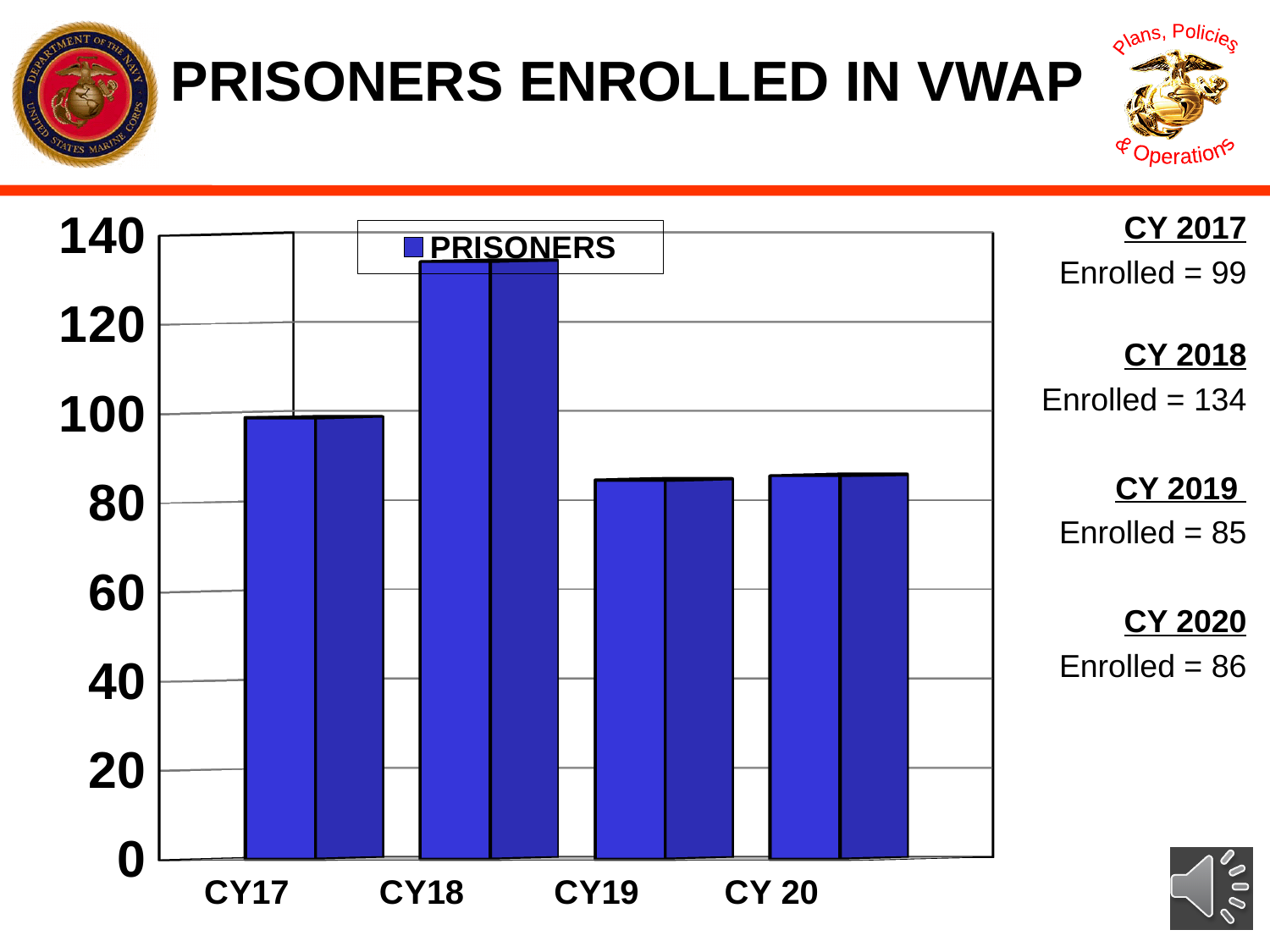
What is the title of the slide containing the chart? PRISONERS ENROLLED IN VWAP What is the difference between the number enrolled in CY 2018 and CY 2017? 35 How many prisoners were enrolled in CY 2018? 134 How many prisoners were enrolled in CY 2020? 86 How many categories are plotted on the x axis of the chart? 4 Which year has the highest number of prisoners enrolled? CY18 How many prisoners were enrolled in CY 2017? 99 What is the name of the series shown in the chart legend? PRISONERS How many prisoners were enrolled in CY 2019? 85 How many series does the chart legend list? 1 What type of chart is shown on the slide? bar chart Is the value for CY18 greater or less than 120? greater